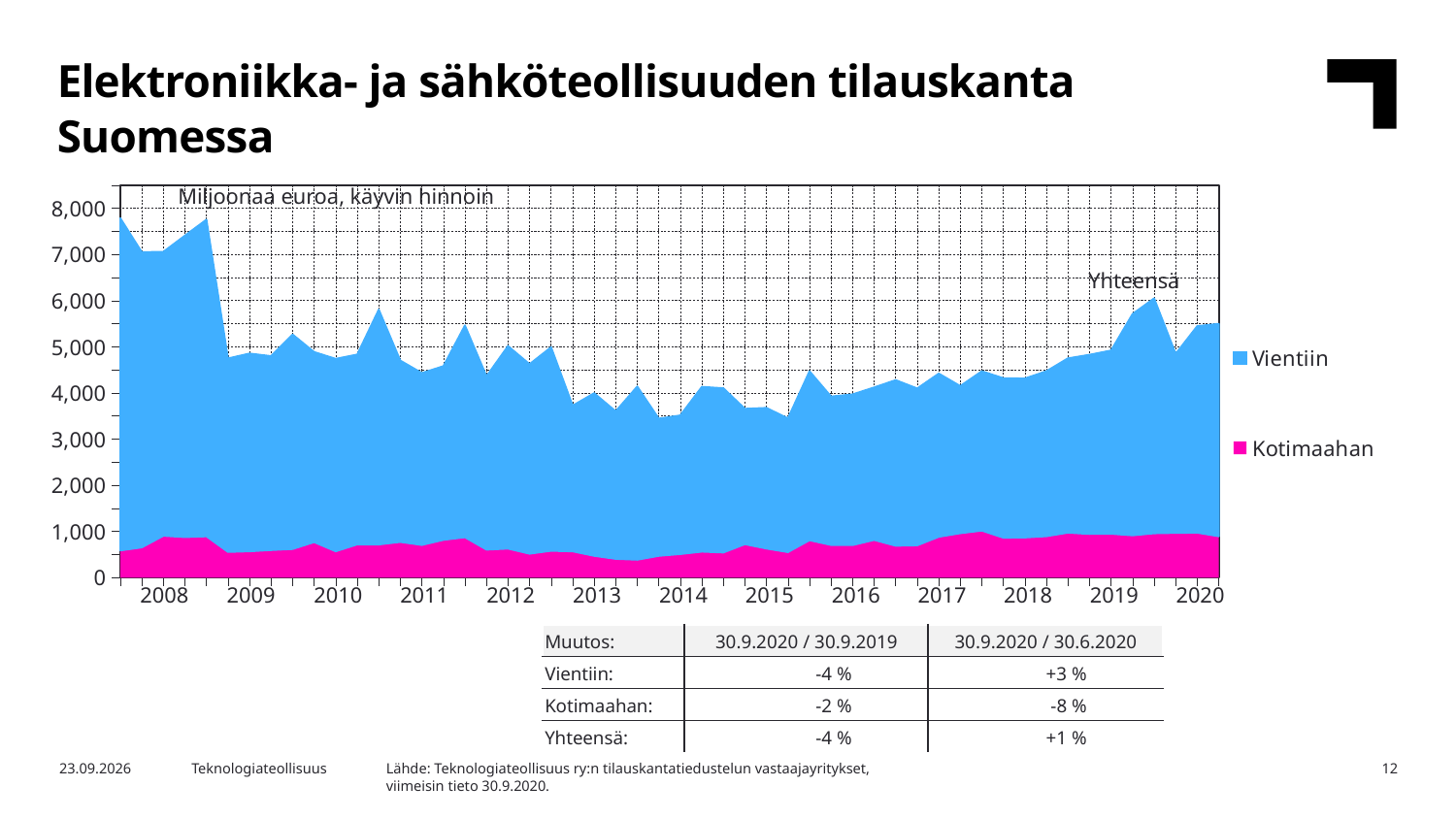
What unit label is printed at the top of the chart? Miljoonaa euroa, käyvin hinnoin Is the Kotimaahan value in 2014 greater or less than 1,000? less Is the total order backlog (Yhteensä) in 2015 greater or less than 5,000? less Does the total order backlog rise or fall from 2008 to 2013? fall Is the total order backlog (Yhteensä) at the end of 2020 greater or less than 5,000? greater How many series does the chart legend list? 2 Is the total order backlog larger at the start of 2008 or in 2015? 2008 What kind of chart is shown on the slide? area chart Which is larger in 2020, the Vientiin series or the Kotimaahan series? Vientiin What are the two series named in the chart legend? Vientiin and Kotimaahan How many year labels are shown on the x axis? 13